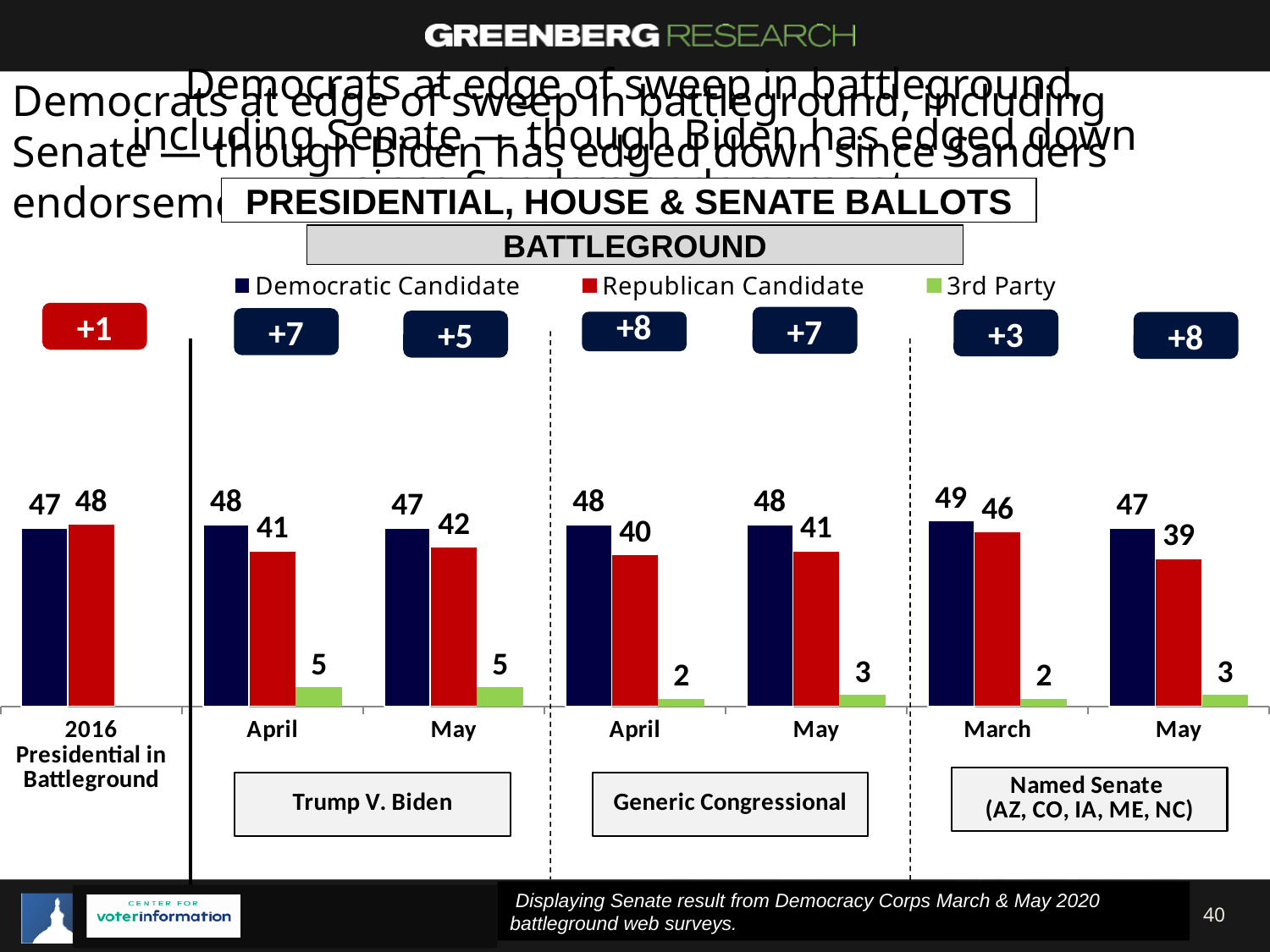
How many series does the legend list? 3 What colour represents the 3rd Party series in the chart? Green Which is larger in the Trump V. Biden April category: the Democratic Candidate value or the Republican Candidate value? Democratic Candidate What is the Republican Candidate value in the Named Senate May category? 39 What is the difference between the Democratic Candidate and Republican Candidate values in the Named Senate March category? 3 What is the 3rd Party value in the Generic Congressional April category? 2 What is the value for the Republican Candidate in the Trump V. Biden May category? 42 In which category does the Democratic Candidate have its highest value? Named Senate March What kind of chart is shown on the slide? Bar chart What is the value for the Democratic Candidate in the 2016 Presidential in Battleground category? 47 How does the Republican Candidate value change from Named Senate March to Named Senate May? It falls In which category does the Republican Candidate have its lowest value? Named Senate May